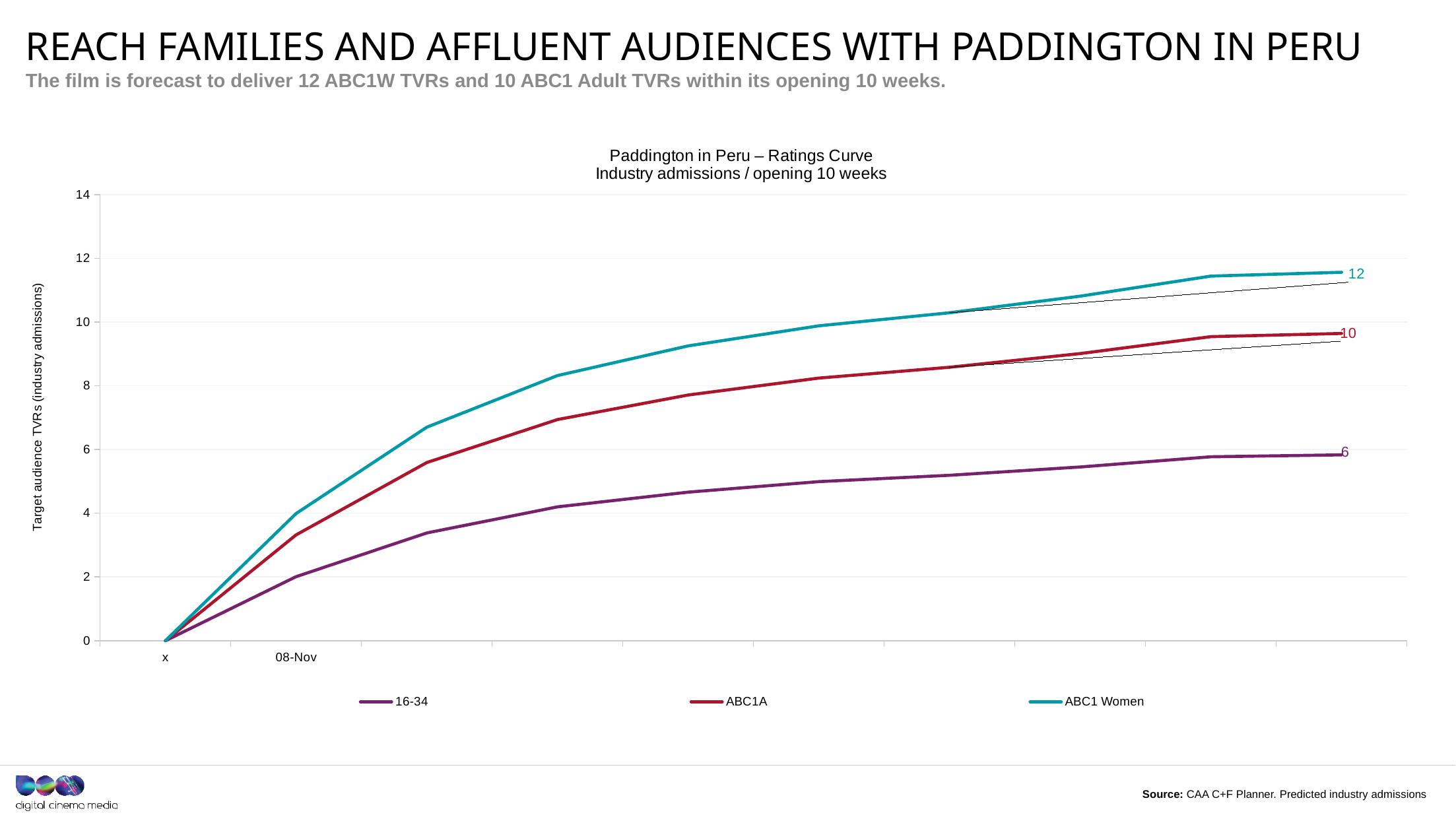
What is the final labelled value for the ABC1 Women series? 12 What is the label on the vertical axis of the chart? Target audience TVRs (industry admissions) What type of chart is shown on the slide? Line chart Do the values for each series rise or fall over the opening 10 weeks? Rise What is the difference between the final values of ABC1 Women and 16-34? 6 What is the final labelled value for the 16-34 series? 6 Which series has the lowest value at the end of the 10 weeks? 16-34 Which series ends higher, ABC1A or 16-34? ABC1A Which series reaches the highest value at the end of the 10 weeks? ABC1 Women How many series does the legend list? 3 Is the value for ABC1 Women at 08-Nov greater or less than 6? less What is the final labelled value for the ABC1A series? 10